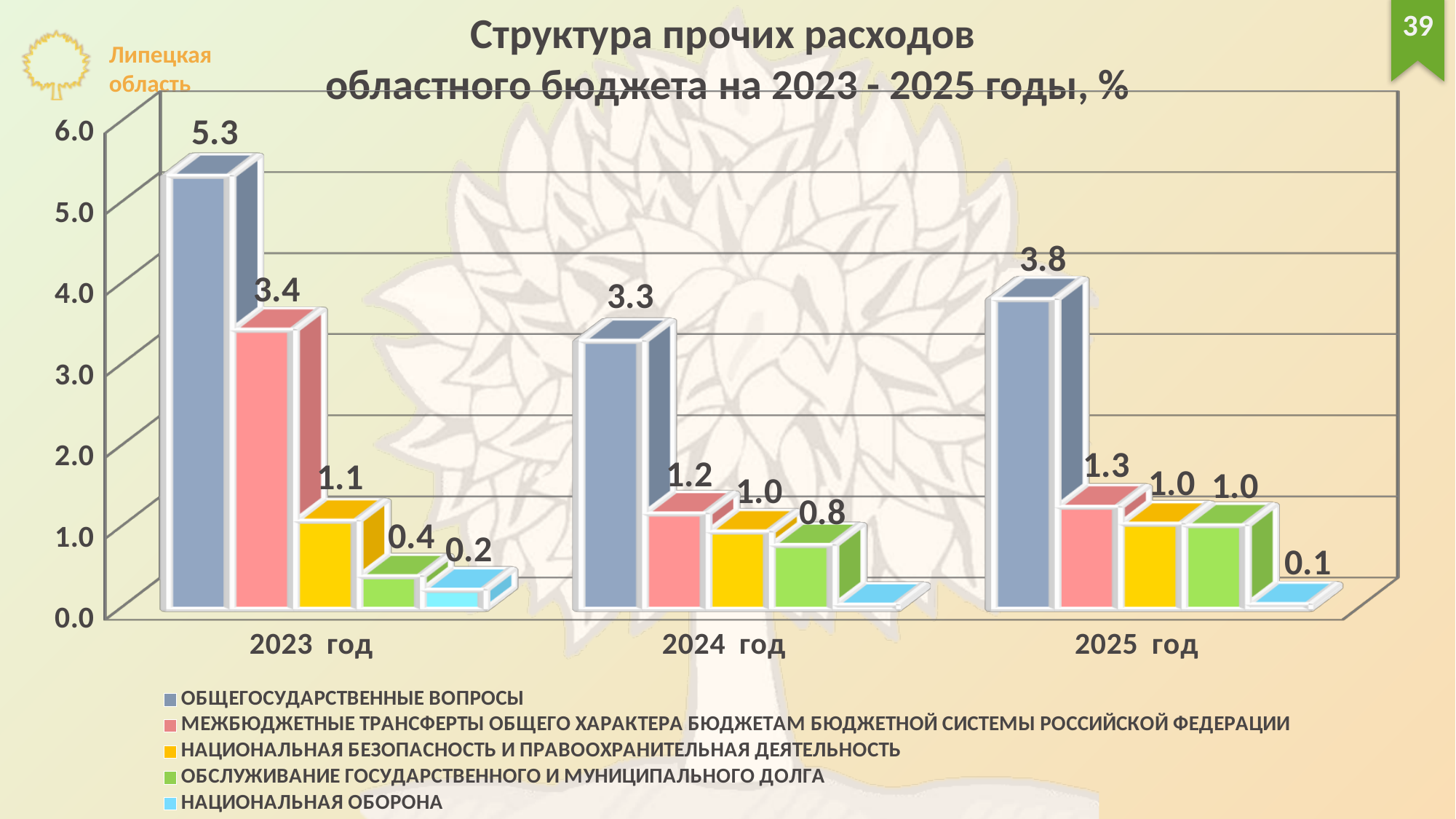
How many series does the legend list? 5 What is the value for ОБЩЕГОСУДАРСТВЕННЫЕ ВОПРОСЫ in 2023 год? 5.3 Is the value for МЕЖБЮДЖЕТНЫЕ ТРАНСФЕРТЫ ОБЩЕГО ХАРАКТЕРА БЮДЖЕТАМ БЮДЖЕТНОЙ СИСТЕМЫ РОССИЙСКОЙ ФЕДЕРАЦИИ in 2023 год greater or less than 3.0? greater In which year is the value for ОБЩЕГОСУДАРСТВЕННЫЕ ВОПРОСЫ the lowest? 2024 год In which year is the value for ОБЩЕГОСУДАРСТВЕННЫЕ ВОПРОСЫ the highest? 2023 год What kind of chart is shown on the slide? bar chart How many years are shown on the x axis? 3 What is the value for МЕЖБЮДЖЕТНЫЕ ТРАНСФЕРТЫ ОБЩЕГО ХАРАКТЕРА БЮДЖЕТАМ БЮДЖЕТНОЙ СИСТЕМЫ РОССИЙСКОЙ ФЕДЕРАЦИИ in 2025 год? 1.3 Which is larger: НАЦИОНАЛЬНАЯ БЕЗОПАСНОСТЬ И ПРАВООХРАНИТЕЛЬНАЯ ДЕЯТЕЛЬНОСТЬ in 2023 год or ОБСЛУЖИВАНИЕ ГОСУДАРСТВЕННОГО И МУНИЦИПАЛЬНОГО ДОЛГА in 2023 год? НАЦИОНАЛЬНАЯ БЕЗОПАСНОСТЬ И ПРАВООХРАНИТЕЛЬНАЯ ДЕЯТЕЛЬНОСТЬ What is the value for НАЦИОНАЛЬНАЯ ОБОРОНА in 2023 год? 0.2 What is the difference between the ОБЩЕГОСУДАРСТВЕННЫЕ ВОПРОСЫ values for 2023 год and 2025 год? 1.5 What is the value for ОБСЛУЖИВАНИЕ ГОСУДАРСТВЕННОГО И МУНИЦИПАЛЬНОГО ДОЛГА in 2024 год? 0.8